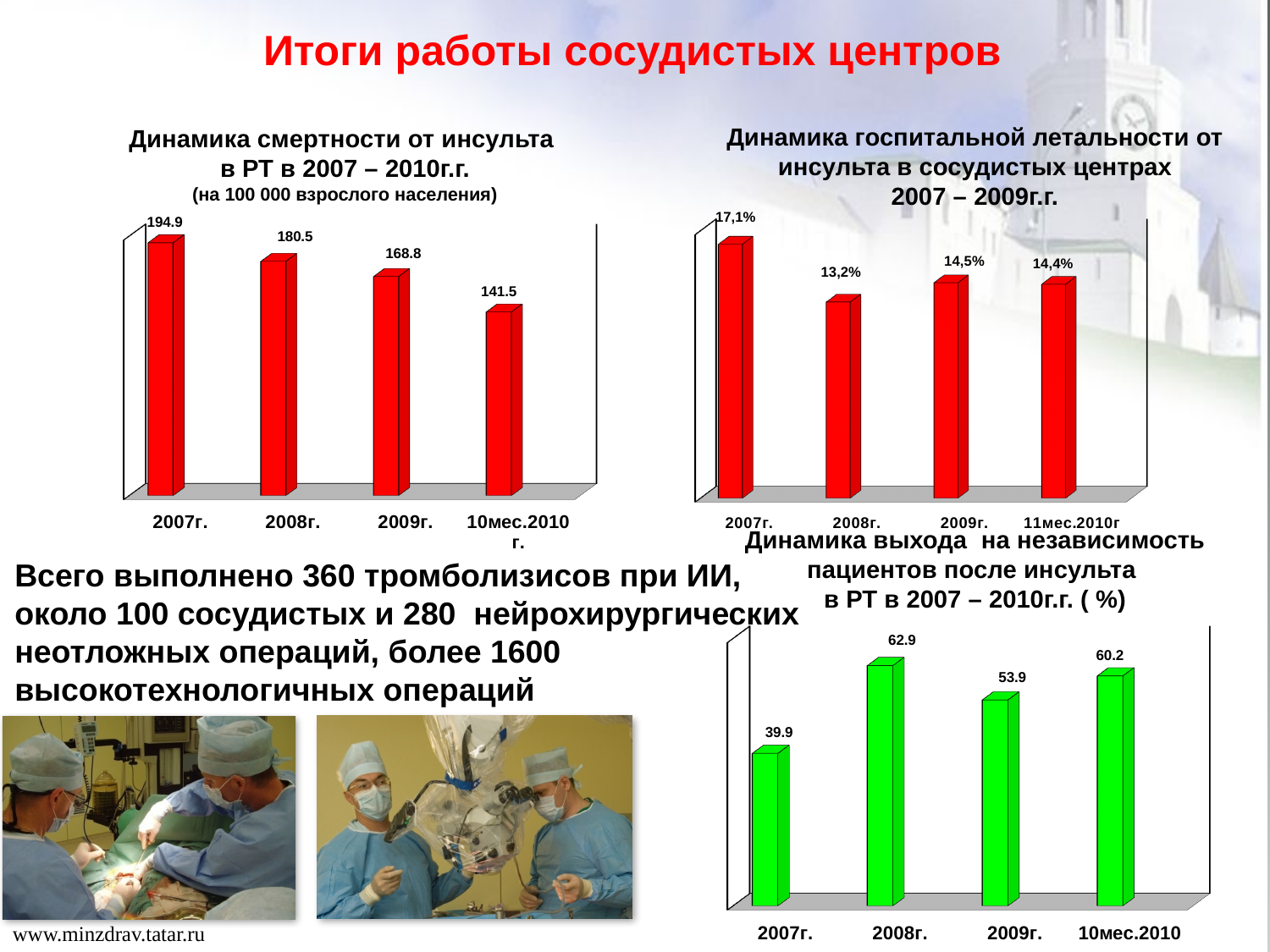
In the top-left chart (Динамика смертности от инсульта в РТ), what is the value for 10мес.2010 г.? 141.5 In the top-left chart (Динамика смертности от инсульта в РТ), do the values rise or fall from 2007г. to 10мес.2010 г.? fall In the top-left chart (Динамика смертности от инсульта в РТ), which category has the lowest value? 10мес.2010 г. In the top-right chart (Динамика госпитальной летальности от инсульта), which category has the highest value? 2007г. In the top-left chart (Динамика смертности от инсульта в РТ), what is the difference between the 2007г. and 2008г. values? 14.4 What type of chart is the bottom-right chart (Динамика выхода на независимость пациентов после инсульта)? bar chart In the top-left chart (Динамика смертности от инсульта в РТ), what is the value for 2007г.? 194.9 In the bottom-right chart (Динамика выхода на независимость пациентов после инсульта), what is the value for 2007г.? 39.9 In the bottom-right chart (Динамика выхода на независимость пациентов после инсульта), which is larger: the value for 2009г. or the value for 10мес.2010? 10мес.2010 In the top-right chart (Динамика госпитальной летальности от инсульта), how many bars are plotted? 4 In the bottom-right chart (Динамика выхода на независимость пациентов после инсульта), which category has the highest value? 2008г. In the top-right chart (Динамика госпитальной летальности от инсульта), what is the value for 2008г.? 13,2%